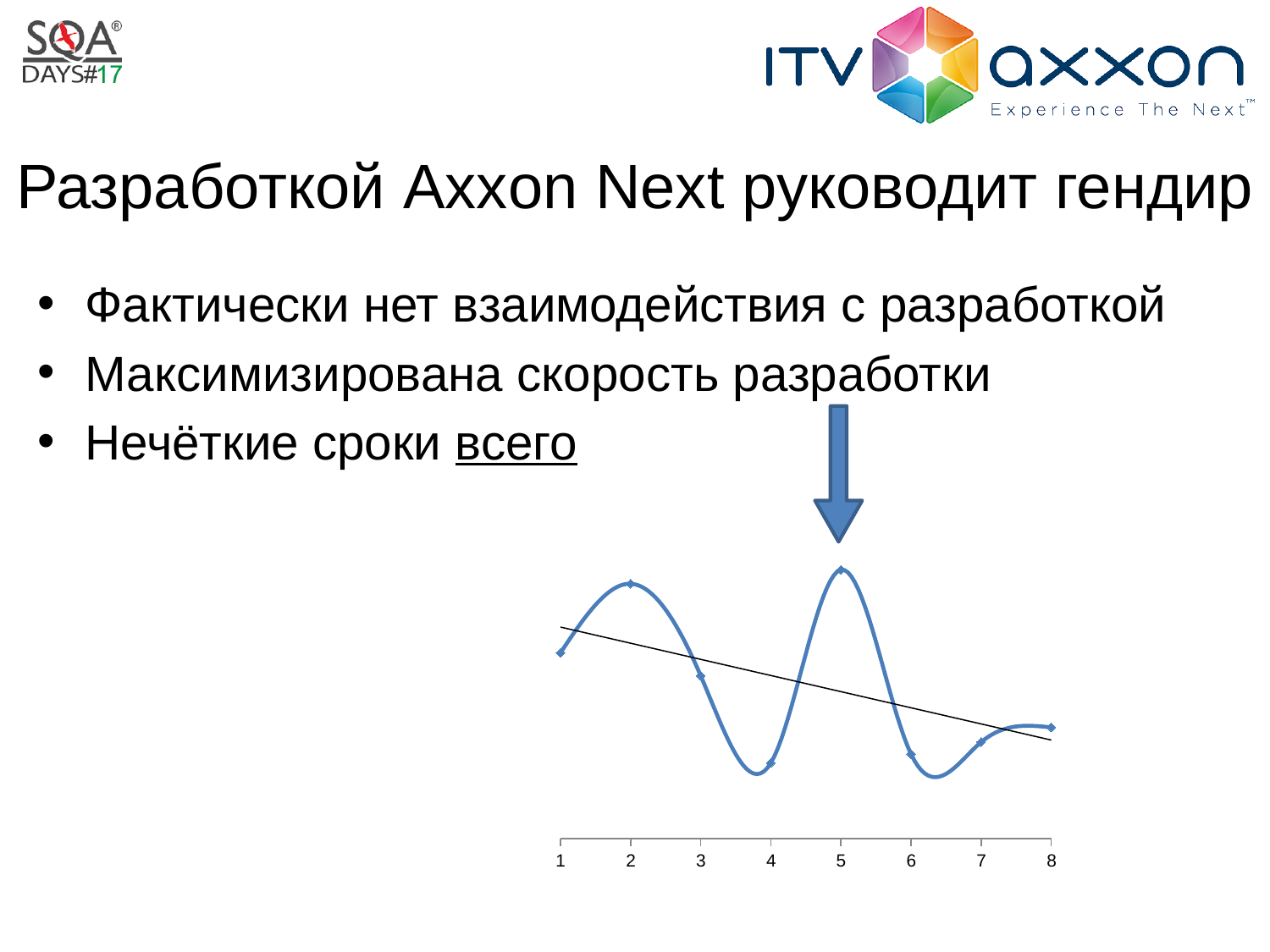
Does the plotted line rise or fall between x = 4 and x = 5? rise Which is higher on the chart, the point at 2 or the point at 4? 2 Does the plotted line rise or fall between x = 2 and x = 4? fall Which is higher on the chart, the point at 1 or the point at 6? 1 What kind of chart is shown on the slide? line chart Does the straight trend line on the chart rise or fall from left to right? fall Which is higher on the chart, the point at 5 or the point at 8? 5 What is the first category label on the x axis of the chart? 1 How many data points are plotted on the line chart? 8 What is the last category label on the x axis of the chart? 8